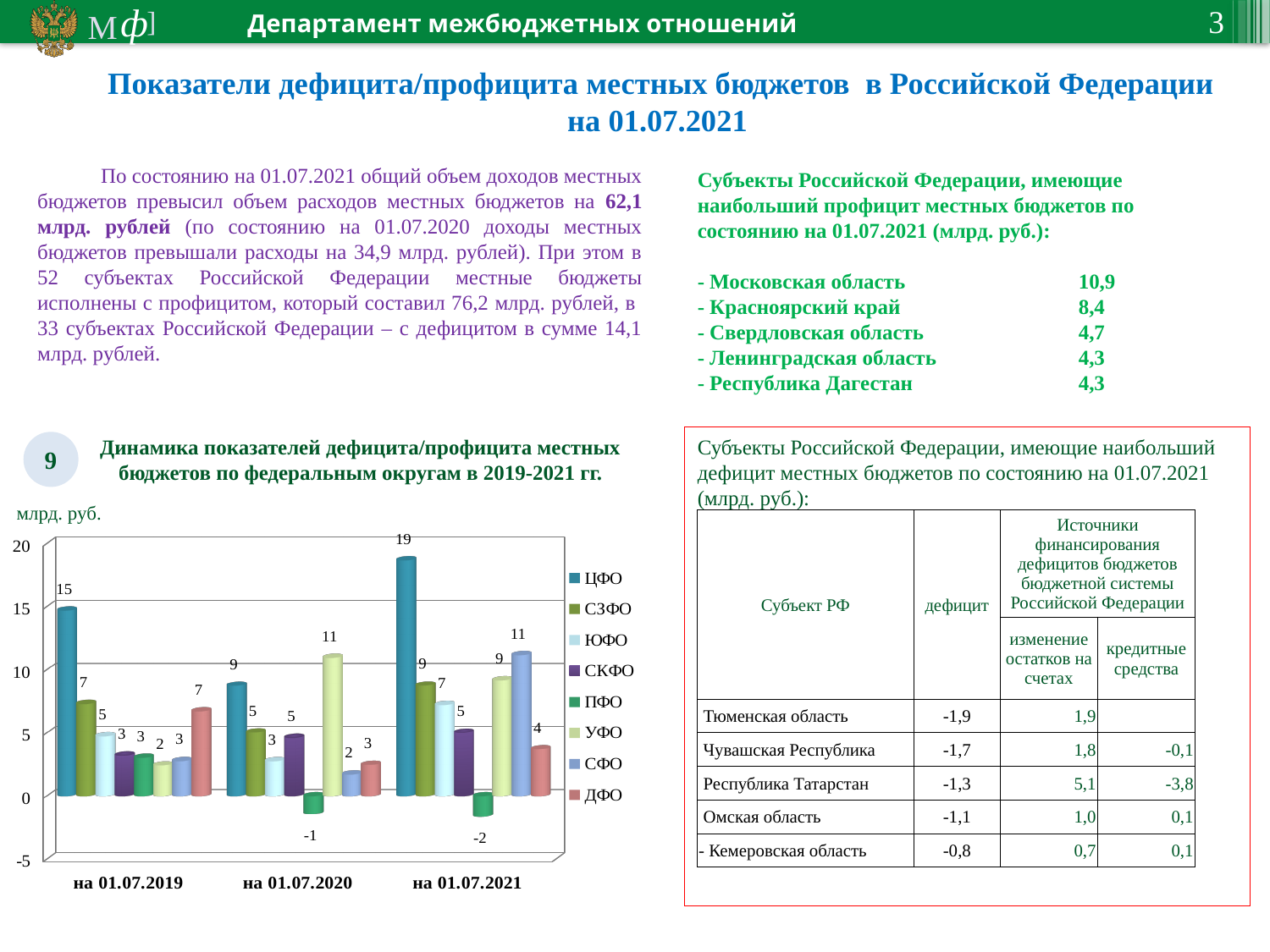
Which federal district has the highest value на 01.07.2019? ЦФО What is the difference between the ЦФО values на 01.07.2021 and на 01.07.2019? 4 How many date categories are shown on the x axis of the chart? 3 How many series does the legend of the chart list? 8 What is the value for ЦФО на 01.07.2021? 19 What is the value for УФО на 01.07.2020? 11 What is the value for ПФО на 01.07.2021? -2 Which is larger на 01.07.2021: the value for СФО or the value for ДФО? СФО What unit is shown above the chart's vertical axis? млрд. руб. How does the value for ЦФО change from 01.07.2019 to 01.07.2020 to 01.07.2021? falls, then rises What type of chart is shown on the slide? bar chart Which federal district has the lowest value на 01.07.2020? ПФО